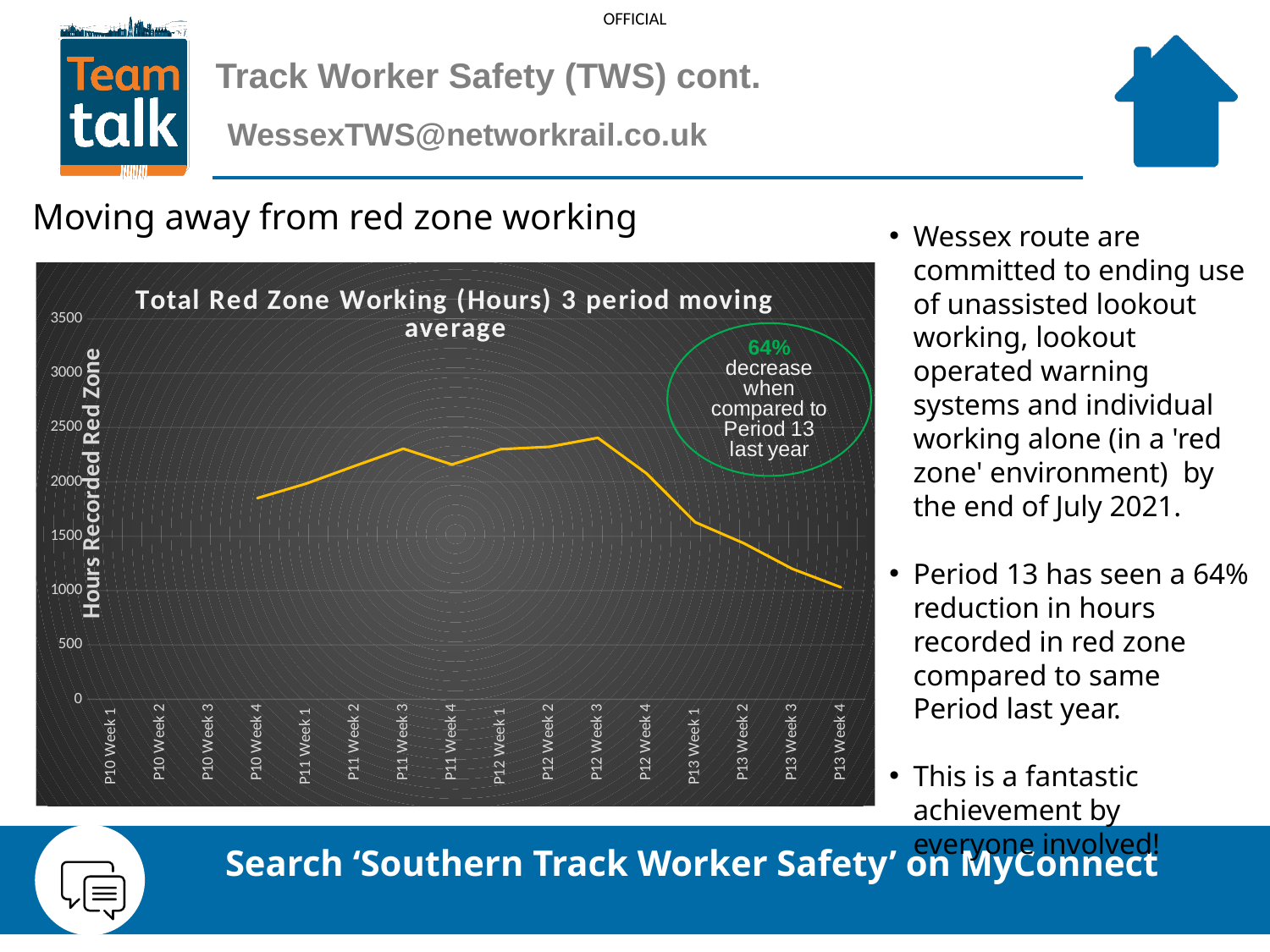
Is the value for P13 Week 4 greater or less than 1500? less Is the value for P13 Week 3 greater or less than 1500? less What is the label of the vertical axis of the chart? Hours Recorded Red Zone How many categories are shown on the x axis of the chart? 16 What is the title of the chart? Total Red Zone Working (Hours) 3 period moving average Do the values rise or fall from P12 Week 3 to P13 Week 4? fall Is the value for P10 Week 4 greater or less than 2000? less Which is larger, the value for P12 Week 3 or the value for P13 Week 4? P12 Week 3 What kind of chart is shown on the slide? Line chart At which x-axis category does the line reach its highest value? P12 Week 3 At which x-axis category does the line reach its lowest value? P13 Week 4